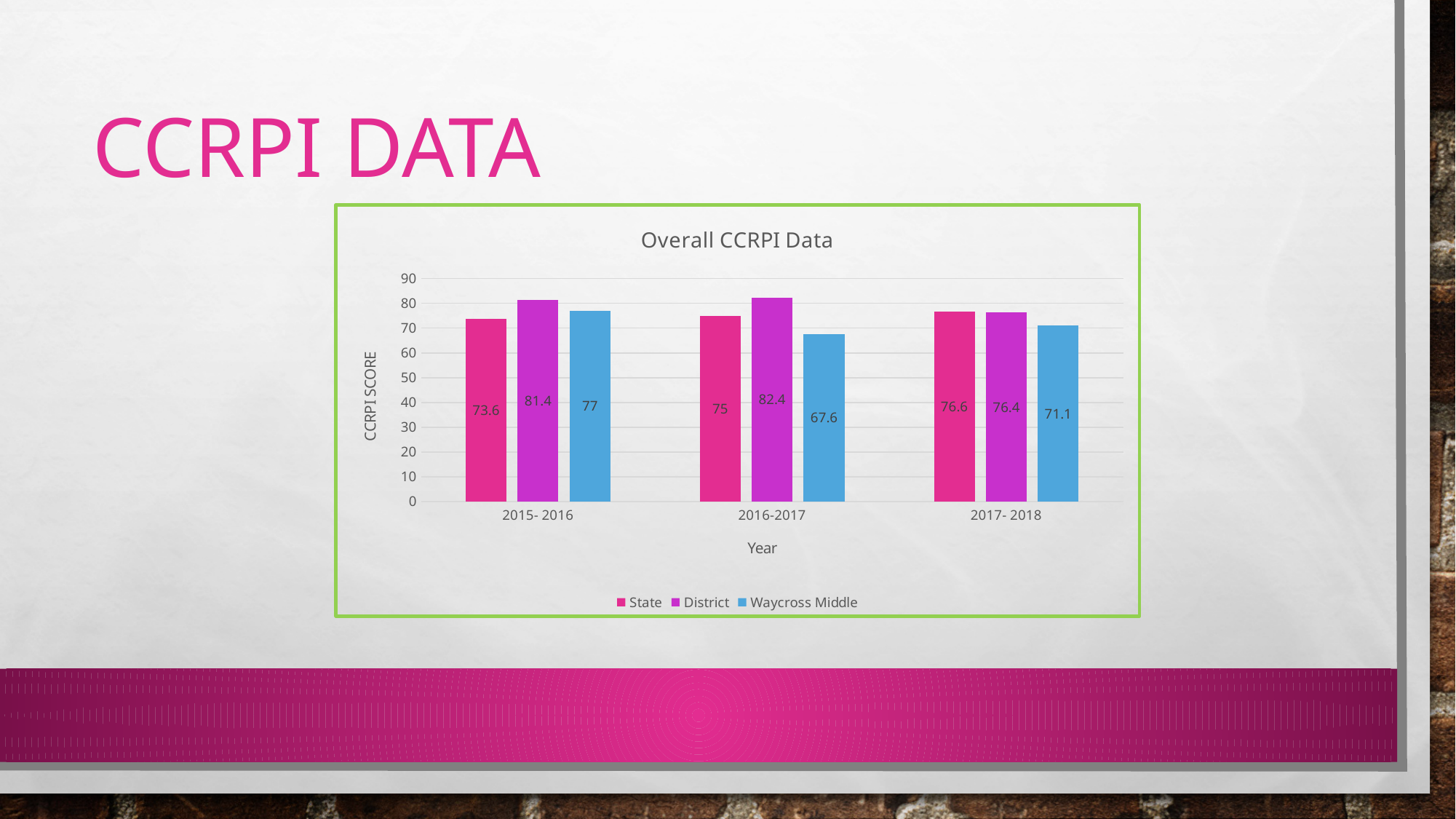
What is the State CCRPI score for 2015- 2016? 73.6 How many series does the legend list? 3 What kind of chart is shown? bar chart What is the Waycross Middle CCRPI score for 2017- 2018? 71.1 Is the Waycross Middle score for 2016-2017 greater or less than 70? less Which is larger in 2017- 2018, the State score or the District score? State Does the State score rise or fall from 2015- 2016 to 2017- 2018? rise What is the difference between the District and Waycross Middle scores in 2016-2017? 14.8 Which year has the lowest State score? 2015- 2016 What is the District CCRPI score for 2016-2017? 82.4 How many years are shown on the x axis? 3 Which year has the highest Waycross Middle score? 2015- 2016